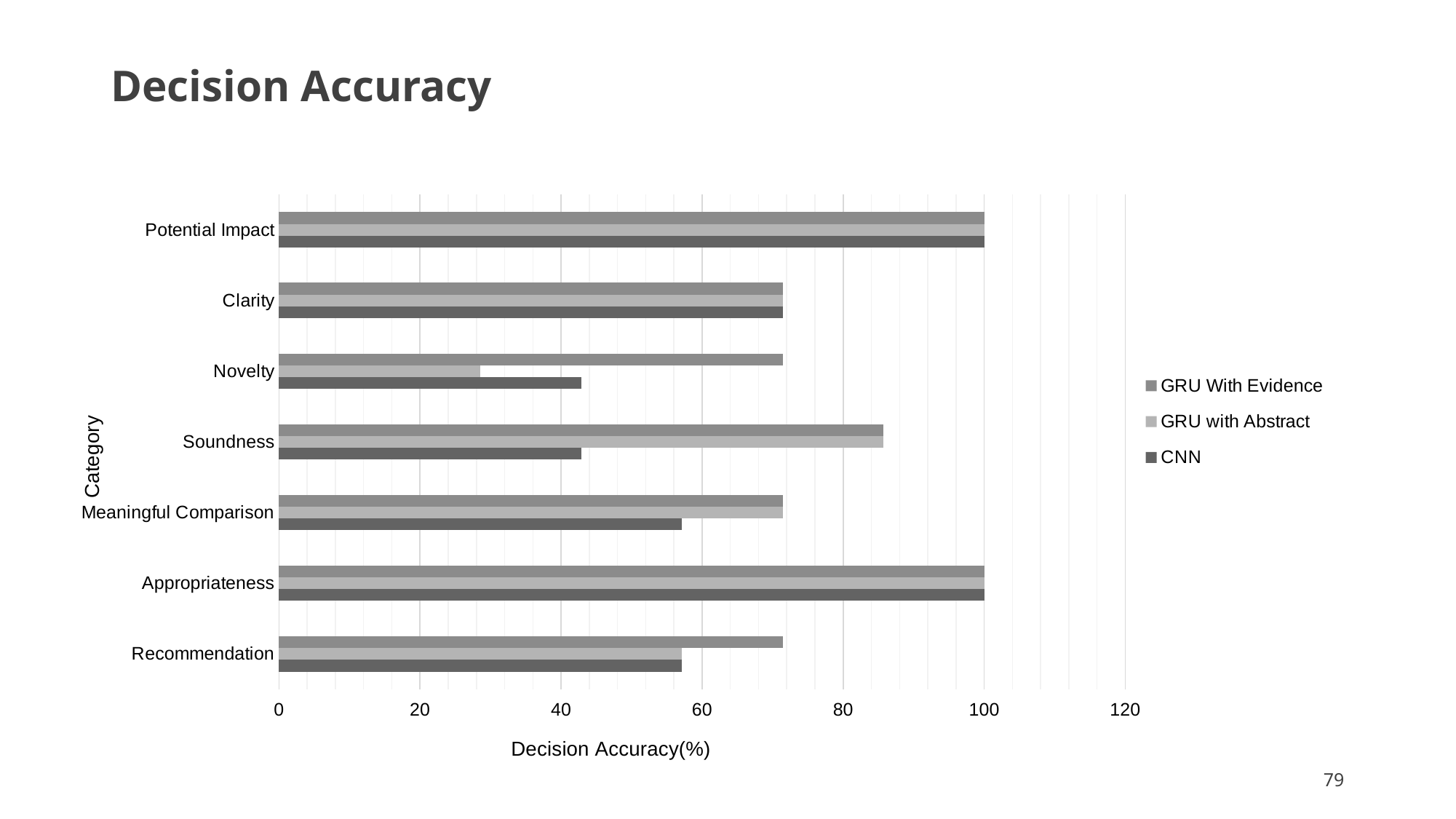
How many categories are shown on the y axis? 7 What is the GRU With Evidence value for Appropriateness? 100 How many series does the legend list? 3 What is the label of the y axis? Category For Novelty, which series has the lowest value? GRU with Abstract Is the GRU with Abstract value for Novelty greater or less than 40? less Is the CNN value for Meaningful Comparison greater or less than 60? less Is the GRU With Evidence value for Soundness greater or less than 80? greater What kind of chart is shown on the slide? bar chart For Soundness, which series has the larger value: GRU With Evidence or CNN? GRU With Evidence What is the label of the x axis? Decision Accuracy(%) What is the CNN value for Potential Impact? 100